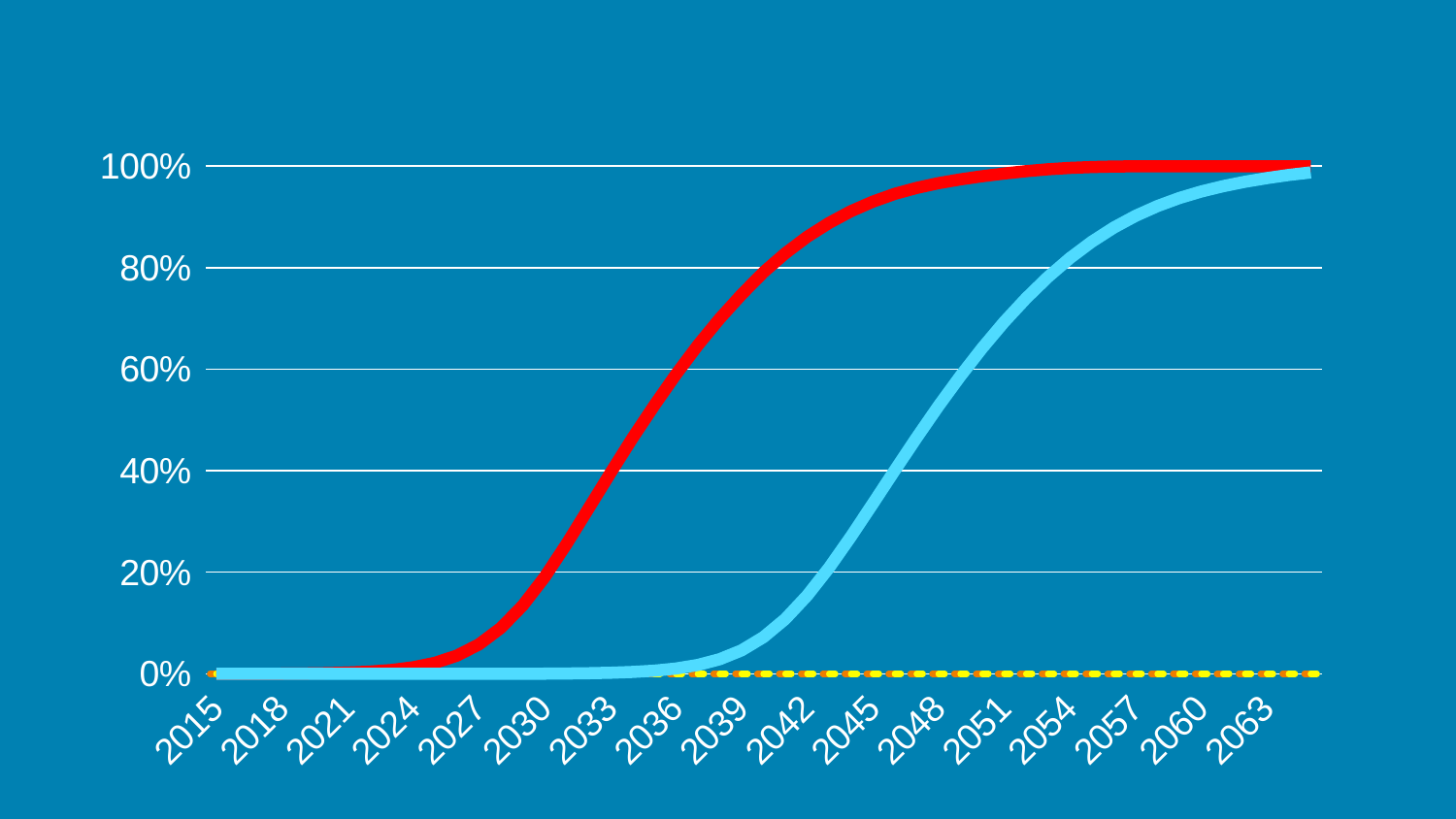
At 2039, which line is higher, the red line or the light blue line? the red line What kind of chart is shown on the slide? line chart Does the light blue line rise or fall as the years increase along the x axis? rise How many year labels are shown on the x axis? 17 Does the red line rise or fall as the years increase along the x axis? rise Is the value of the light blue line at 2042 greater or less than 40%? less Is the value of the red line at 2036 greater or less than 40%? greater Which line reaches 80% first, the red line or the light blue line? the red line Is the value of the red line at 2027 greater or less than 20%? less What is the highest value labelled on the y axis? 100%